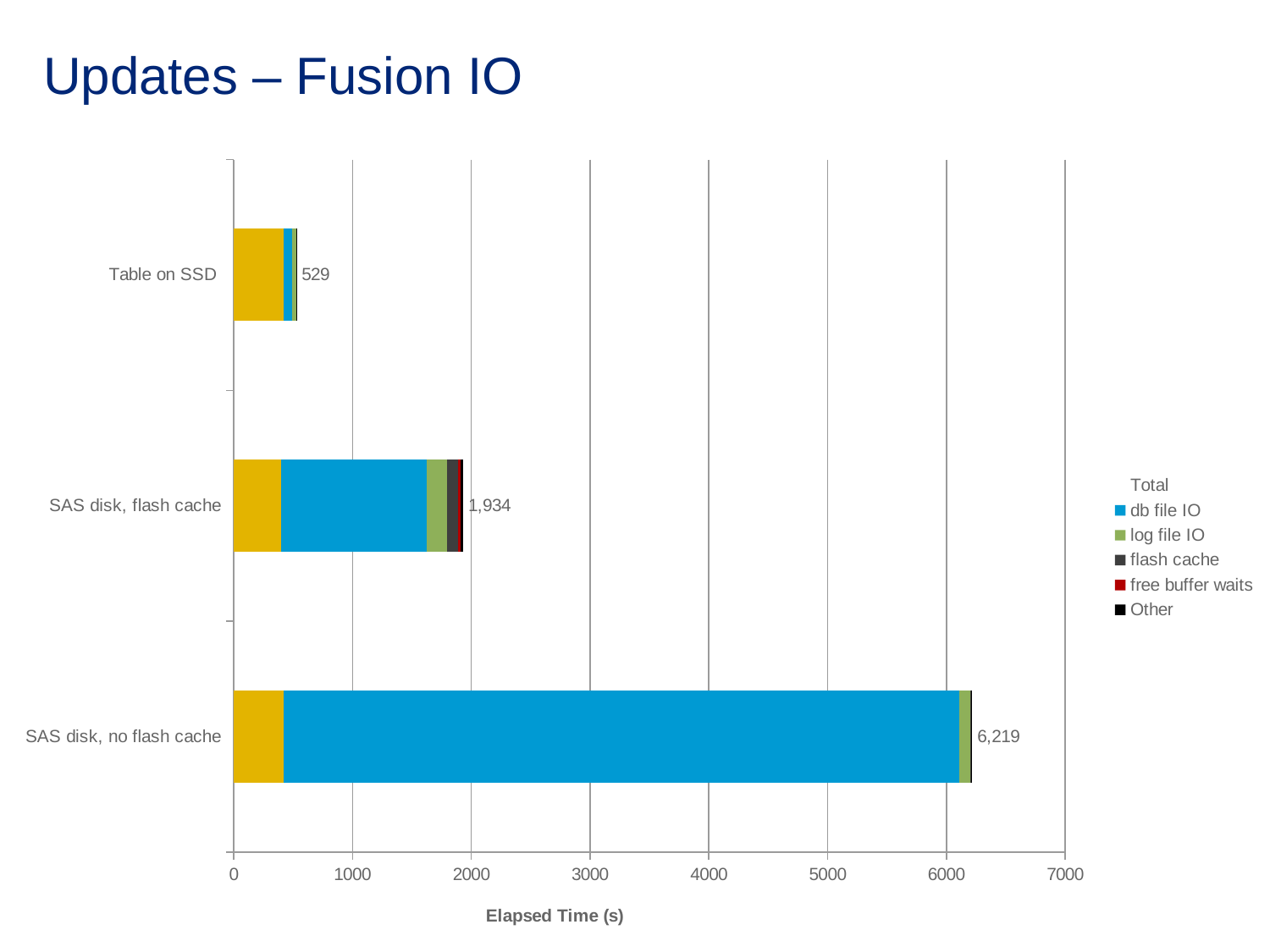
How many categories are shown on the chart? 3 What kind of chart is shown on the slide? Stacked bar chart Which category has the lowest total elapsed time? Table on SSD What is the label of the horizontal axis? Elapsed Time (s) Which category has the highest total elapsed time? SAS disk, no flash cache What is the difference in total elapsed time between SAS disk, flash cache and Table on SSD? 1,405 Which has a larger total elapsed time, SAS disk, flash cache or Table on SSD? SAS disk, flash cache What is the total elapsed time for SAS disk, no flash cache? 6,219 What is the total elapsed time for Table on SSD? 529 What is the difference in total elapsed time between SAS disk, no flash cache and SAS disk, flash cache? 4,285 Is the total elapsed time for SAS disk, flash cache greater or less than 2000? less What is the total elapsed time for SAS disk, flash cache? 1,934